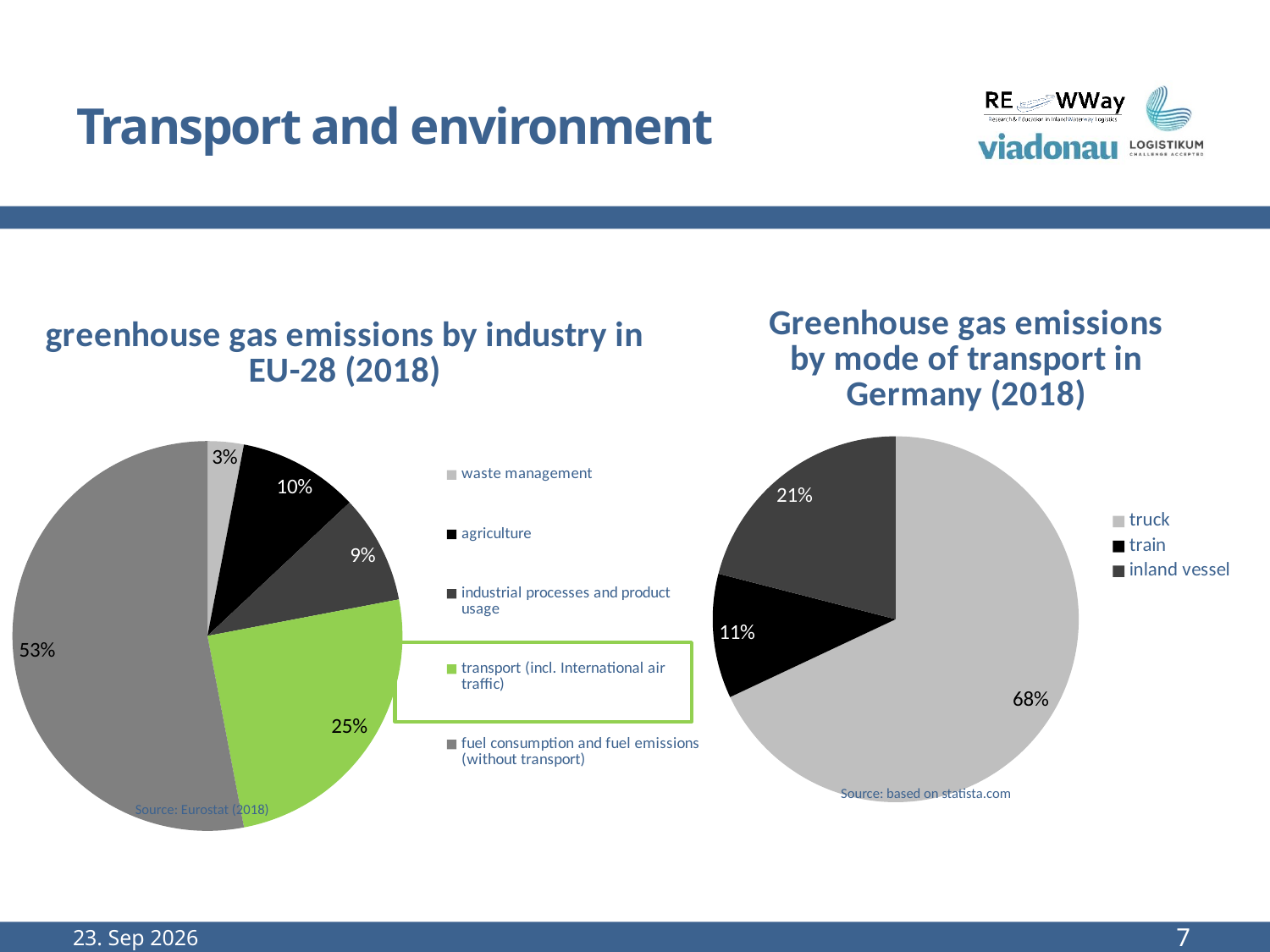
In the 'Greenhouse gas emissions by mode of transport in Germany (2018)' chart, what is the difference in percentage points between truck and inland vessel? 47 percentage points In the 'Greenhouse gas emissions by mode of transport in Germany (2018)' chart, what share does inland vessel have? 21% In the 'greenhouse gas emissions by industry in EU-28 (2018)' chart, which category has the largest share? fuel consumption and fuel emissions (without transport) What type of chart is used for 'Greenhouse gas emissions by mode of transport in Germany (2018)'? pie chart In the 'greenhouse gas emissions by industry in EU-28 (2018)' chart, what share does fuel consumption and fuel emissions (without transport) have? 53% In the 'Greenhouse gas emissions by mode of transport in Germany (2018)' chart, what share does truck have? 68% In the 'Greenhouse gas emissions by mode of transport in Germany (2018)' chart, which mode has the smallest share? train In the 'greenhouse gas emissions by industry in EU-28 (2018)' chart, how many categories does the legend list? 5 In the 'greenhouse gas emissions by industry in EU-28 (2018)' chart, what is the difference in percentage points between agriculture and industrial processes and product usage? 1 percentage point In the 'greenhouse gas emissions by industry in EU-28 (2018)' chart, what share does waste management have? 3% In the 'greenhouse gas emissions by industry in EU-28 (2018)' chart, what share does transport (incl. International air traffic) have? 25% In the 'greenhouse gas emissions by industry in EU-28 (2018)' chart, which category has the smallest share? waste management